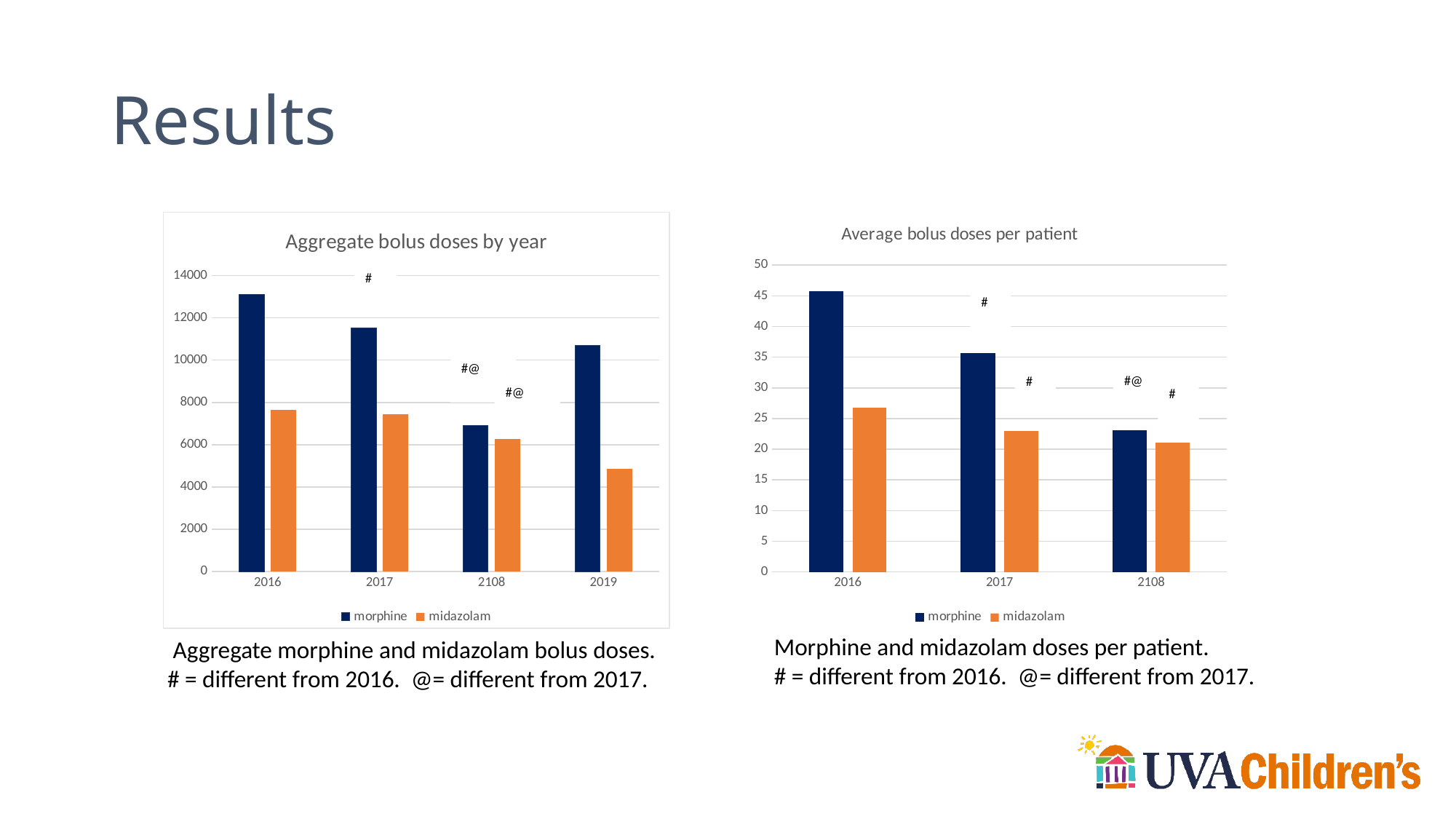
In the 'Aggregate bolus doses by year' chart, which year has the highest morphine value? 2016 What colour are the midazolam bars in the 'Aggregate bolus doses by year' chart? orange In the 'Aggregate bolus doses by year' chart, is the midazolam value for 2019 greater or less than 6000? less In the 'Aggregate bolus doses by year' chart, is the morphine value for 2016 greater or less than 12000? greater In the 'Average bolus doses per patient' chart, do the midazolam values rise or fall from 2016 to 2108? fall In the 'Average bolus doses per patient' chart, which is larger for 2017: morphine or midazolam? morphine What kind of chart is the 'Aggregate bolus doses by year' chart? bar chart How many series does the legend of the 'Average bolus doses per patient' chart list? 2 In the 'Aggregate bolus doses by year' chart, which year has the lowest midazolam value? 2019 In the 'Average bolus doses per patient' chart, which year has the highest morphine value? 2016 In the 'Average bolus doses per patient' chart, is the morphine value for 2016 greater or less than 40? greater How many year categories does the 'Aggregate bolus doses by year' chart show? 4